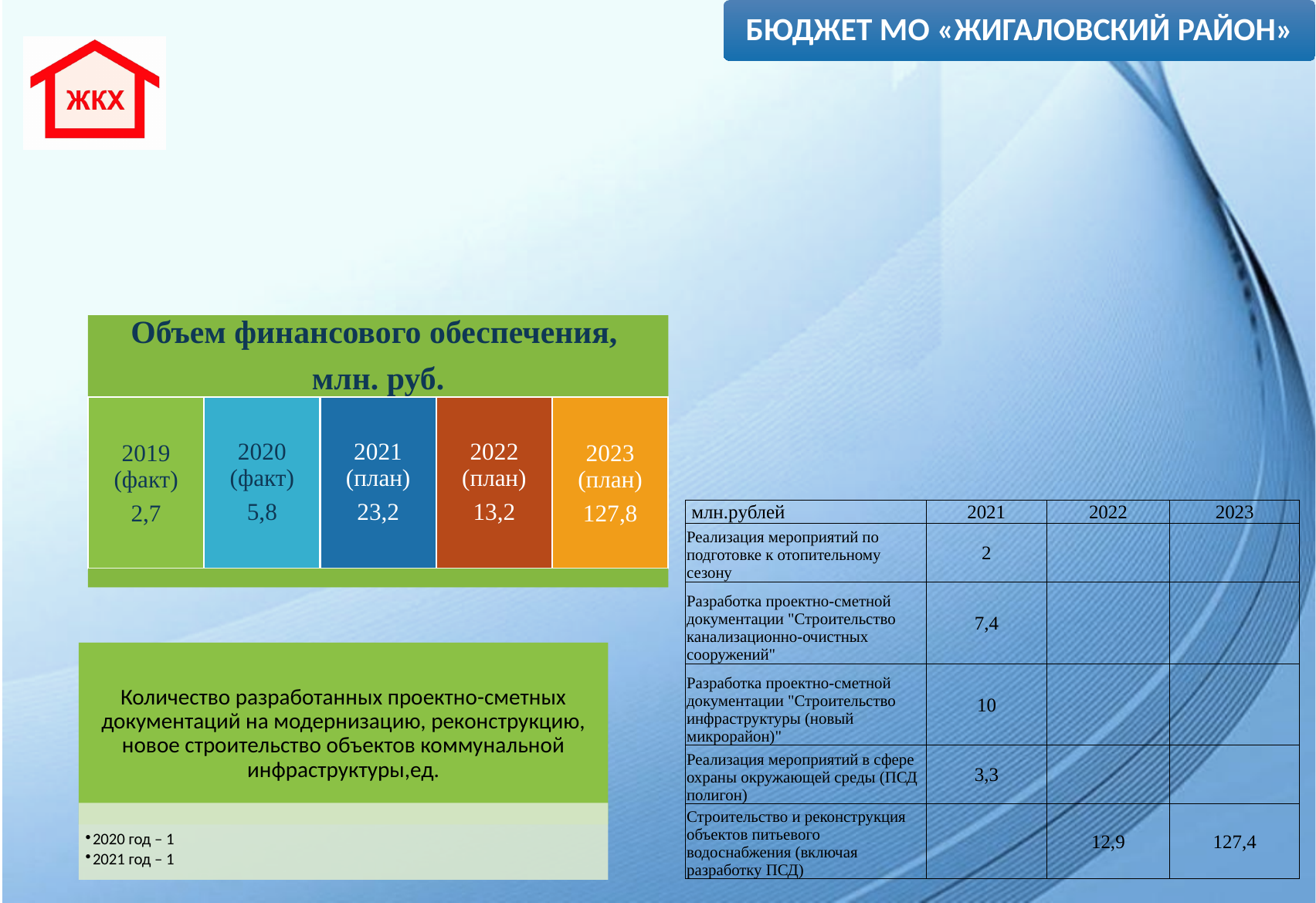
In the chart 'Объем финансового обеспечения, млн. руб.', what is the value for 2023 (план)? 127,8 In the chart 'Объем финансового обеспечения, млн. руб.', which year has the highest value? 2023 (план) In the chart 'Объем финансового обеспечения, млн. руб.', which year has the lowest value? 2019 (факт) In the chart 'Объем финансового обеспечения, млн. руб.', what colour is the block for 2023 (план)? Orange In the chart 'Объем финансового обеспечения, млн. руб.', which is larger, the value for 2021 (план) or 2022 (план)? 2021 (план) In the chart 'Объем финансового обеспечения, млн. руб.', what is the value for 2021 (план)? 23,2 In the chart 'Объем финансового обеспечения, млн. руб.', what is the value for 2019 (факт)? 2,7 How many years are shown in the chart 'Объем финансового обеспечения, млн. руб.'? 5 In the chart 'Объем финансового обеспечения, млн. руб.', how many years are marked as 'факт'? 2 What is the title of the chart on the left side of the slide? Объем финансового обеспечения, млн. руб. In the chart 'Объем финансового обеспечения, млн. руб.', what is the difference between the 2021 (план) and 2022 (план) values? 10 In the chart 'Объем финансового обеспечения, млн. руб.', what is the difference between the 2020 (факт) and 2019 (факт) values? 3,1